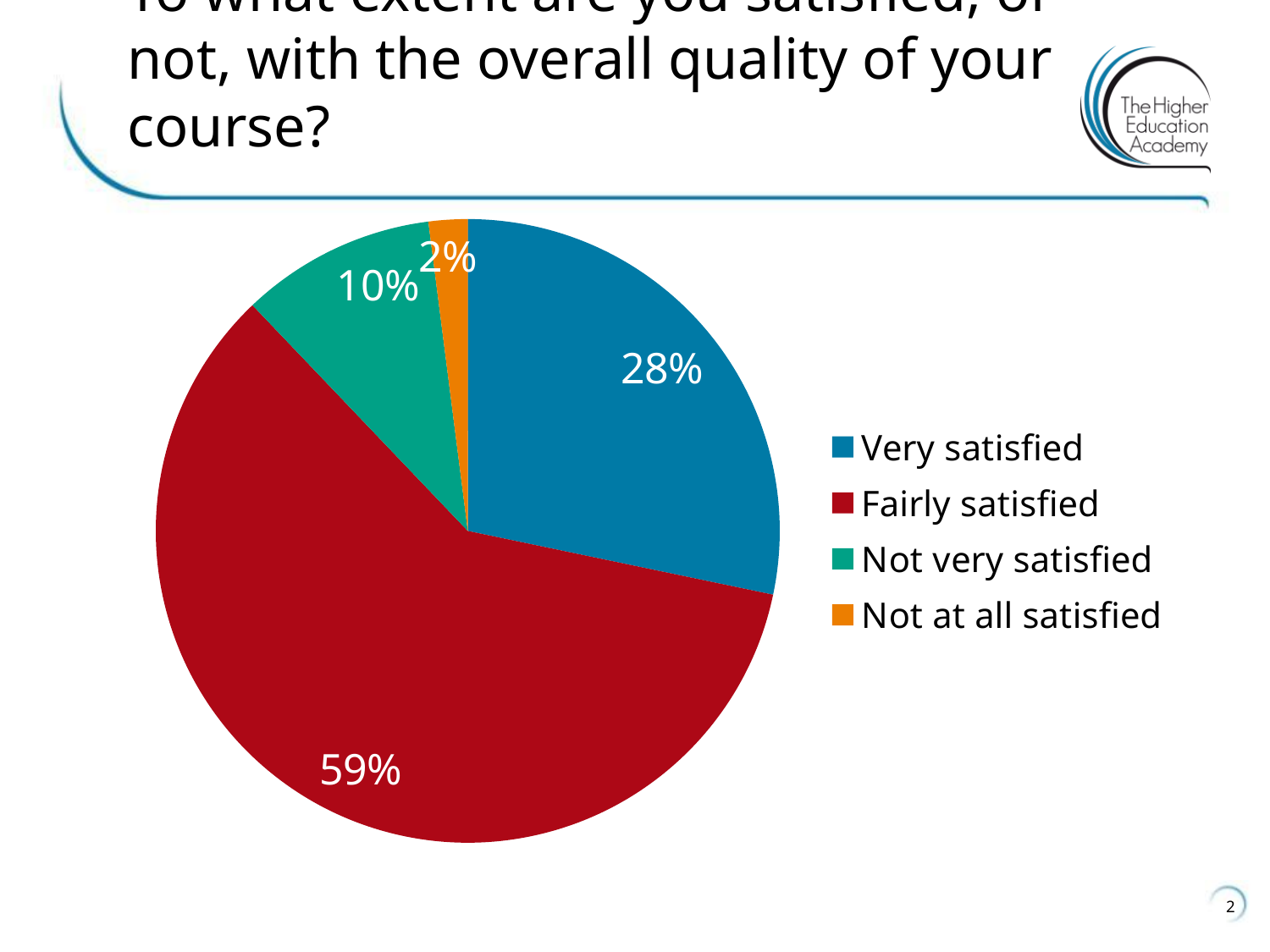
What percentage of respondents were Not very satisfied? 10% What is the combined percentage of respondents who were Very satisfied or Fairly satisfied? 87% Which response category has the smallest share of the pie? Not at all satisfied Which response category has the largest share of the pie? Fairly satisfied What percentage of respondents were Very satisfied? 28% How many response categories are shown in the pie chart? 4 What percentage of respondents were Fairly satisfied? 59% Which is larger: the share for Very satisfied or the share for Not very satisfied? Very satisfied What is the difference in percentage points between Fairly satisfied and Very satisfied? 31 Which colour represents Not very satisfied in the legend? Green What kind of chart is shown on the slide? Pie chart What percentage of respondents were Not at all satisfied? 2%